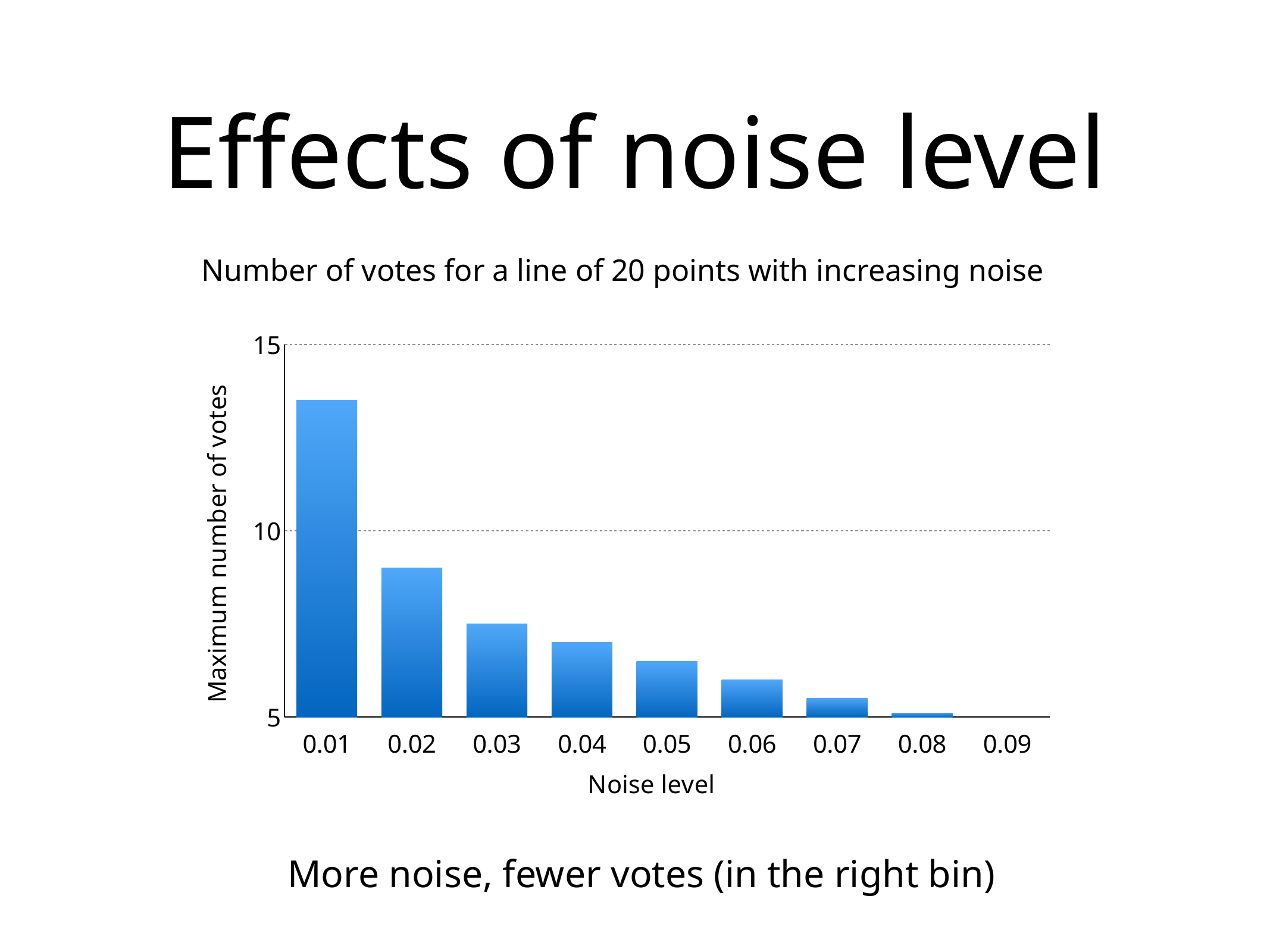
Is the value for noise level 0.01 greater or less than 15? less Is the value for noise level 0.02 greater or less than 10? less Which noise level has the highest maximum number of votes? 0.01 Which has a higher maximum number of votes, noise level 0.07 or noise level 0.03? 0.03 Is the value for noise level 0.01 greater or less than 10? greater What is the label of the y axis? Maximum number of votes How many noise levels are shown on the x axis? 9 Which has a higher maximum number of votes, noise level 0.02 or noise level 0.06? 0.02 What is the title of the chart? Number of votes for a line of 20 points with increasing noise What kind of chart is shown on the slide? bar chart Do the values rise or fall as the noise level increases along the x axis? fall